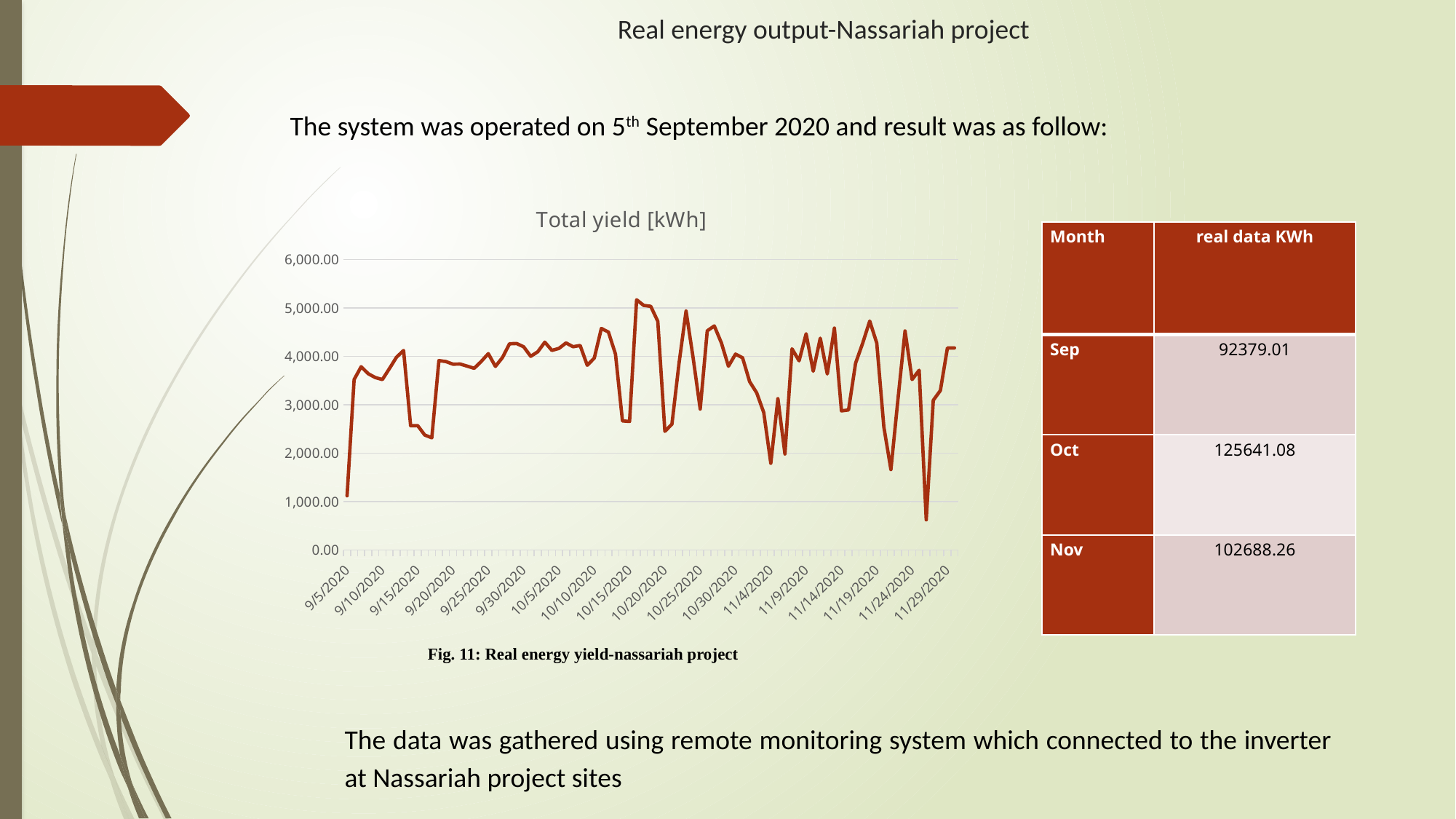
What is the first date label on the x axis of the chart? 9/5/2020 Is the highest value on the chart greater or less than 5,000? greater Is the value for 10/5/2020 greater or less than 3,000? greater What kind of chart is shown on the slide? line chart What is the title of the chart? Total yield [kWh] Which is larger, the value for 9/5/2020 or the value for 10/5/2020? 10/5/2020 Is the value for 9/5/2020 greater or less than 2,000? less